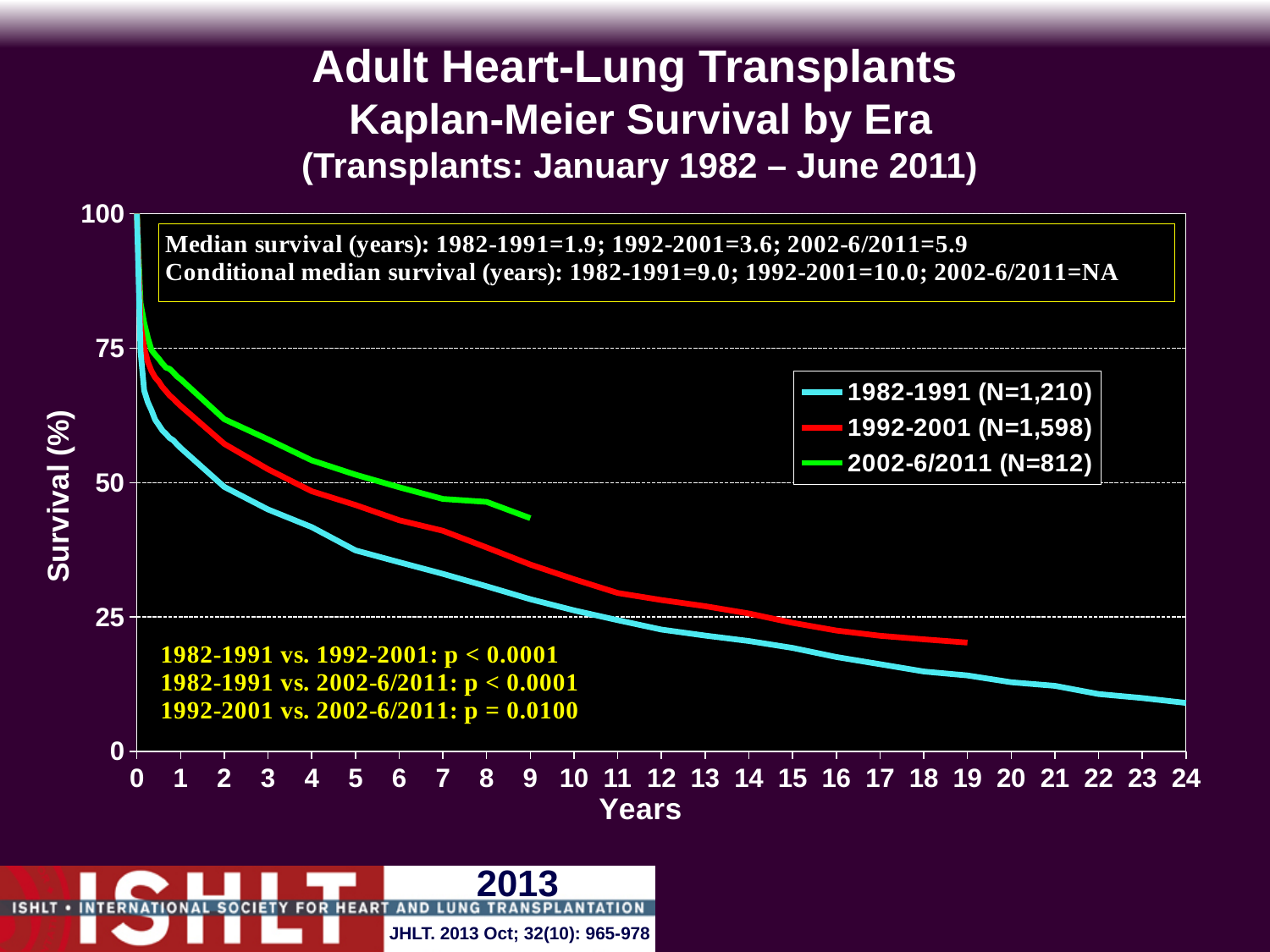
Do the survival curves rise or fall as years increase? fall Is the survival value for 1982-1991 at year 5 greater or less than 50? less Which era has the lowest survival curve? 1982-1991 How many series does the legend list? 3 What is the N for the 1982-1991 series in the legend? 1,210 At year 5, which era has higher survival, 1982-1991 or 1992-2001? 1992-2001 Is the survival value for 2002-6/2011 at year 2 greater or less than 50? greater What kind of chart is shown on the slide? line chart What is the median survival in years for the 1992-2001 era, as printed on the slide? 3.6 What is the label of the y axis? Survival (%) Which era has the highest survival curve across the years it covers? 2002-6/2011 Is the survival value for 1992-2001 at year 19 greater or less than 25? less